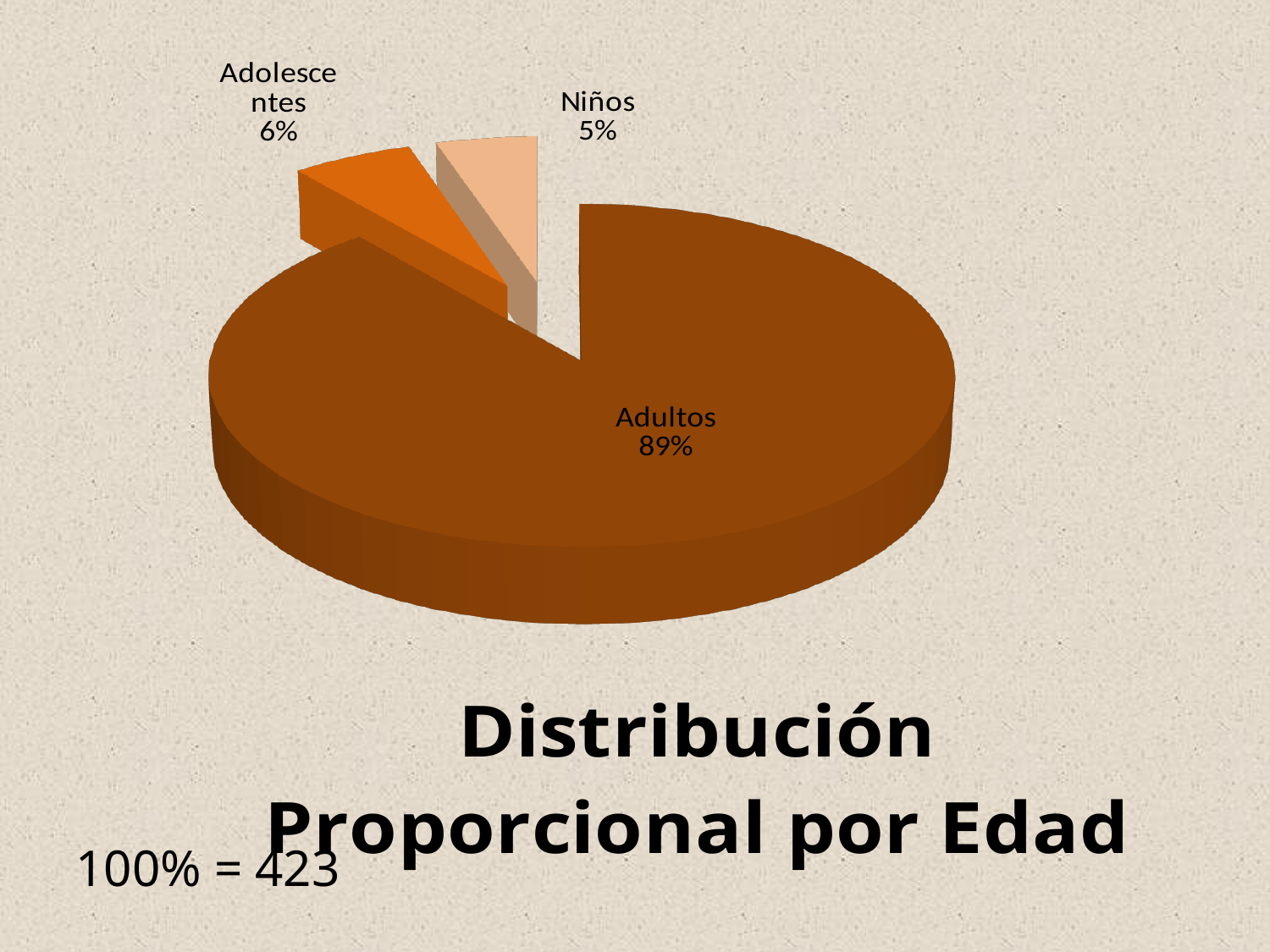
Which category has the largest share of the pie? Adultos According to the slide, what total count corresponds to 100%? 423 What is the difference in percentage points between Adolescentes and Niños? 1 What is the difference in percentage points between Adultos and Adolescentes? 83 What percentage of the pie does the Adultos slice represent? 89% Which is larger, the share for Adolescentes or the share for Niños? Adolescentes What kind of chart is shown on the slide? Pie chart How many categories are shown in the pie chart? 3 What percentage is shown for Niños? 5% What is the title of the chart? Distribución Proporcional por Edad What percentage is shown for Adolescentes? 6% Which category has the smallest share of the pie? Niños